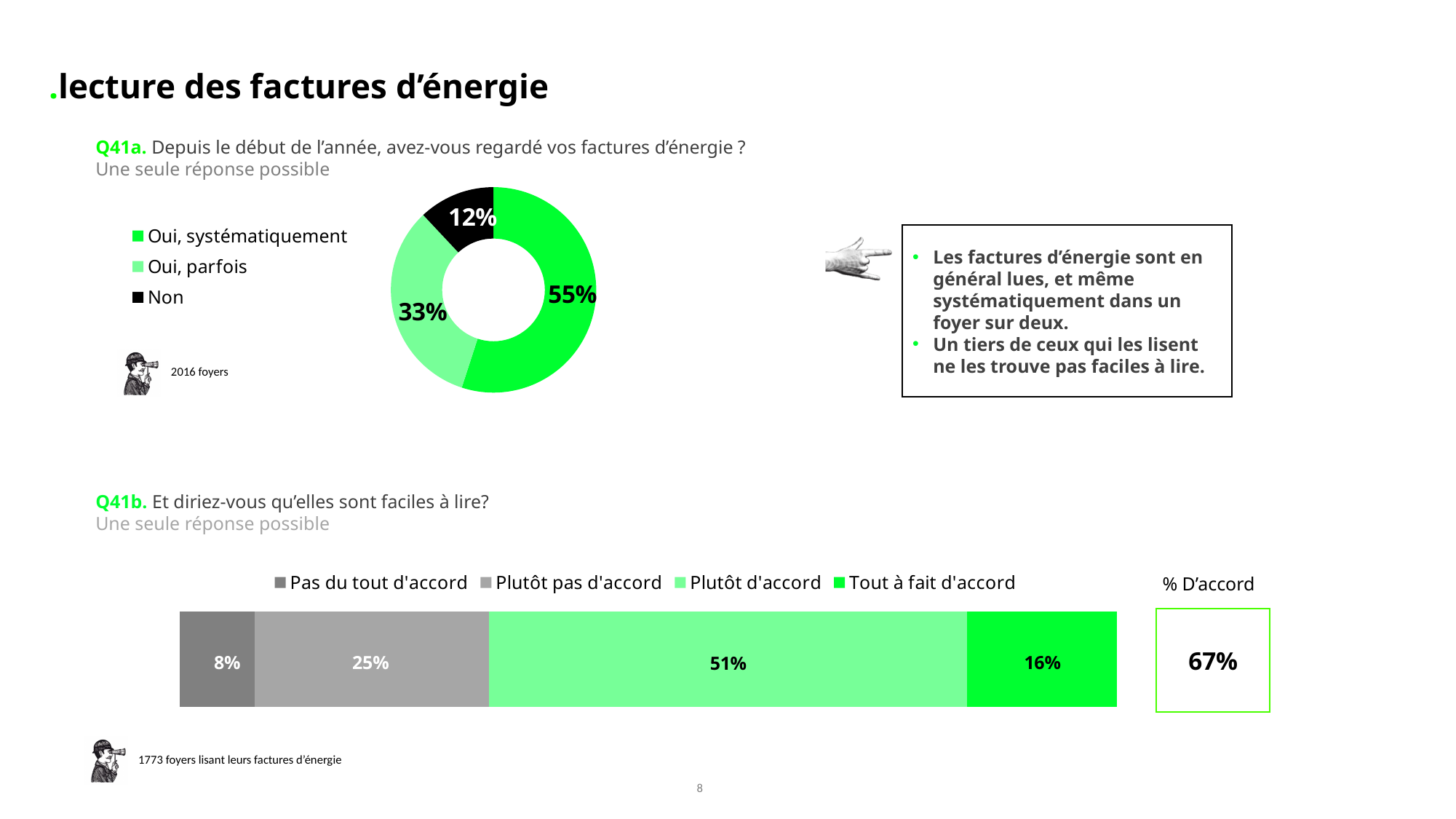
What kind of chart is used for Q41a? Pie (donut) chart In the Q41b chart, which is larger: "Plutôt pas d'accord" or "Tout à fait d'accord"? Plutôt pas d'accord In the Q41b chart, what percentage answered "Plutôt d'accord"? 51% In the Q41a chart, which response has the largest share? Oui, systématiquement In the Q41b chart, what percentage answered "Pas du tout d'accord"? 8% In the Q41a chart, what share of households answered "Oui, systématiquement"? 55% In the Q41a chart, which response has the smallest share? Non How many categories does the Q41a chart legend list? 3 How many series does the Q41b chart legend list? 4 In the Q41a chart, what is the difference between the "Oui, systématiquement" and "Oui, parfois" shares? 22% In the Q41b chart, what is the combined share of "Plutôt d'accord" and "Tout à fait d'accord"? 67% In the Q41a chart, what share of households answered "Non"? 12%